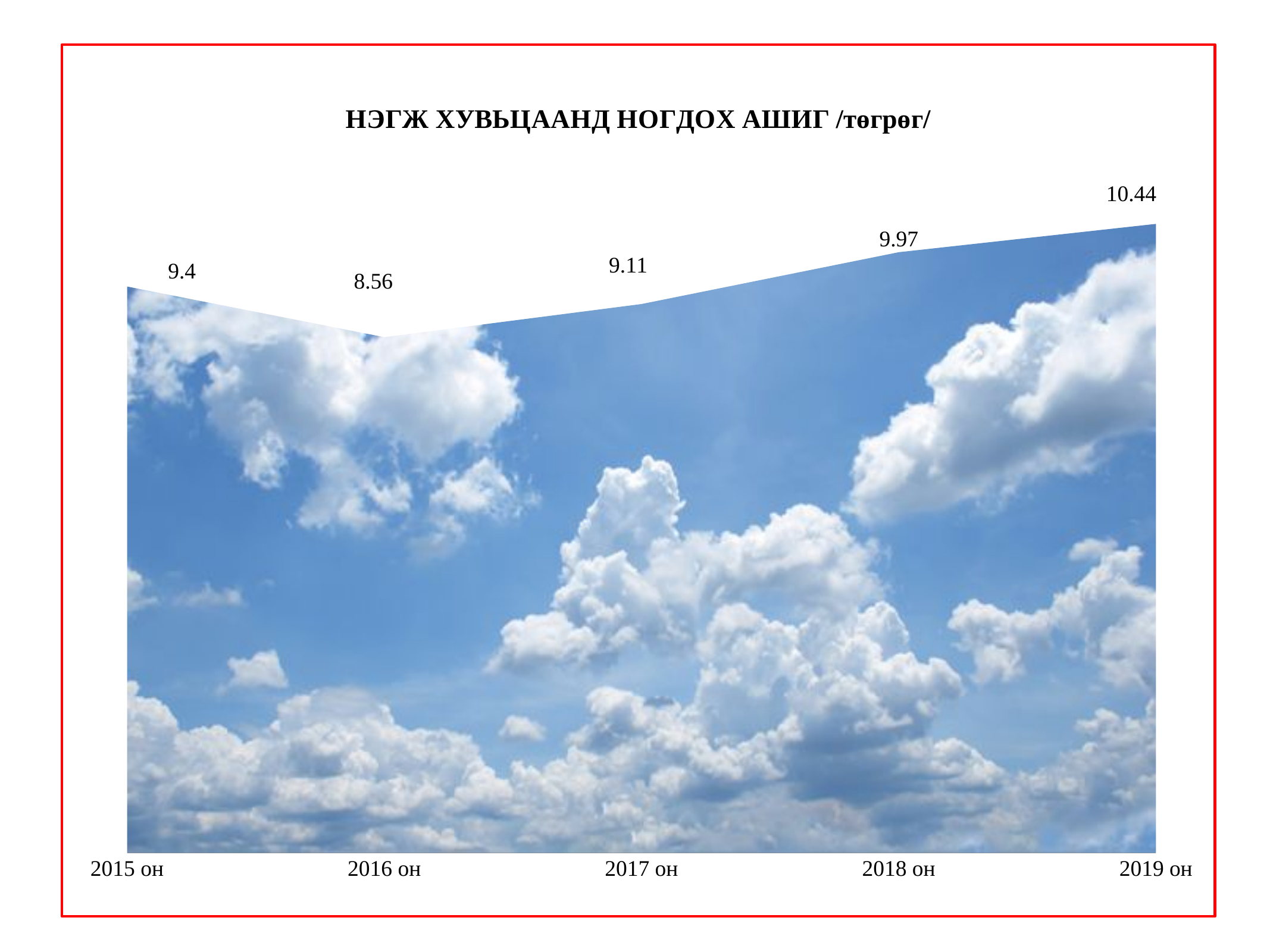
What is the value for 2015 он? 9.4 What is the difference between the values for 2015 он and 2016 он? 0.84 Which is larger, the value for 2015 он or the value for 2017 он? 2015 он What kind of chart is this? area chart How many years are shown on the x axis? 5 What is the value for 2019 он? 10.44 Which year has the highest value? 2019 он What is the difference between the values for 2019 он and 2018 он? 0.47 Do the values rise or fall from 2016 он to 2019 он? rise What is the title of the chart? НЭГЖ ХУВЬЦААНД НОГДОХ АШИГ /төгрөг/ What is the value for 2017 он? 9.11 Which year has the lowest value? 2016 он